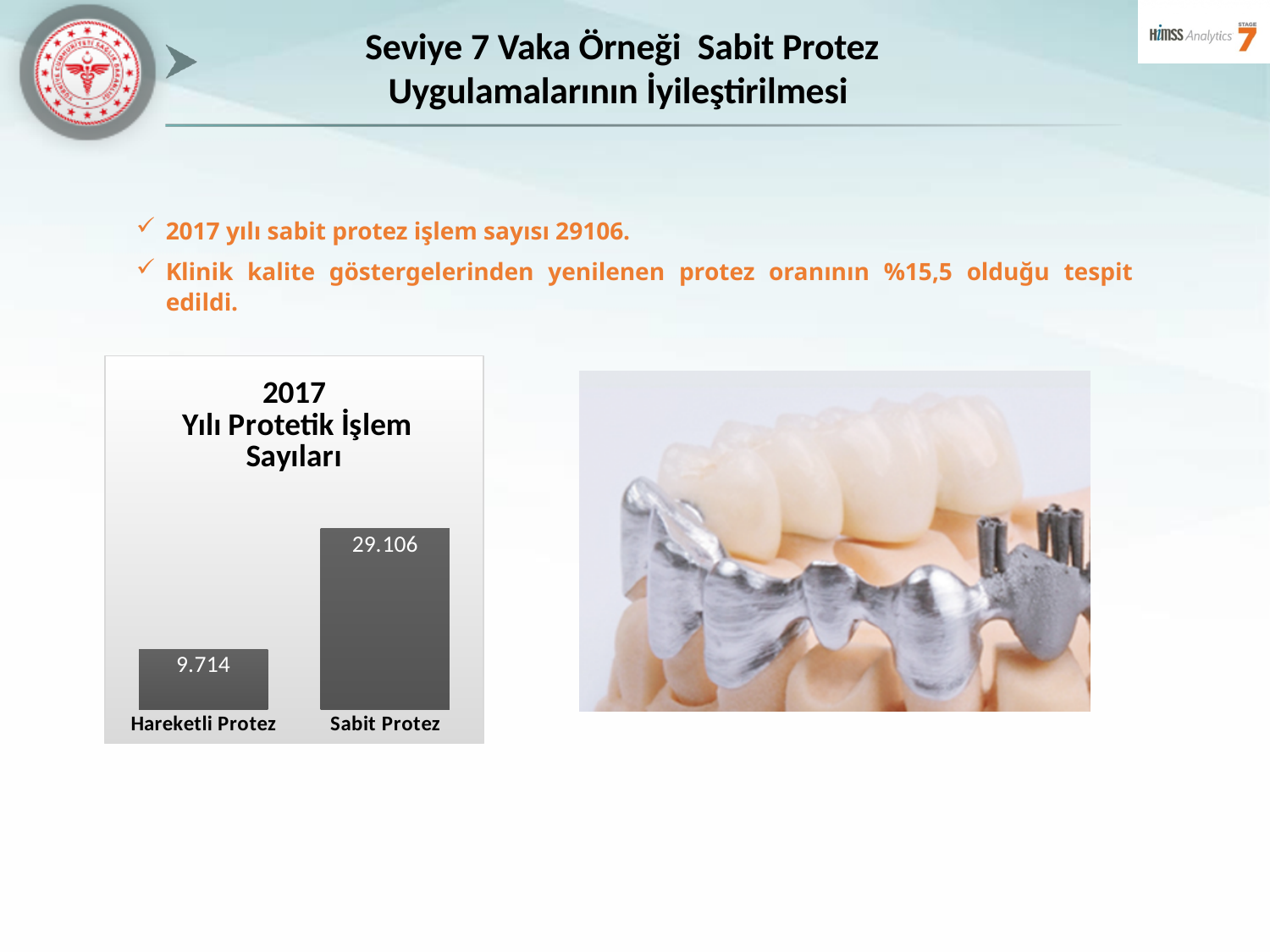
What is the title of the chart? 2017 Yılı Protetik İşlem Sayıları Which category has the highest value in the chart? Sabit Protez What colour are the bars in the chart? Dark grey What is the difference between the values for Sabit Protez and Hareketli Protez? 19.392 What is the value for Hareketli Protez in the chart? 9.714 Which is larger, the value for Hareketli Protez or the value for Sabit Protez? Sabit Protez How many categories are shown in the chart? 2 What is the value for Sabit Protez in the chart? 29.106 What is the total of the two values shown in the chart? 38.820 What kind of chart is shown on the slide? Bar chart Which category has the lowest value in the chart? Hareketli Protez